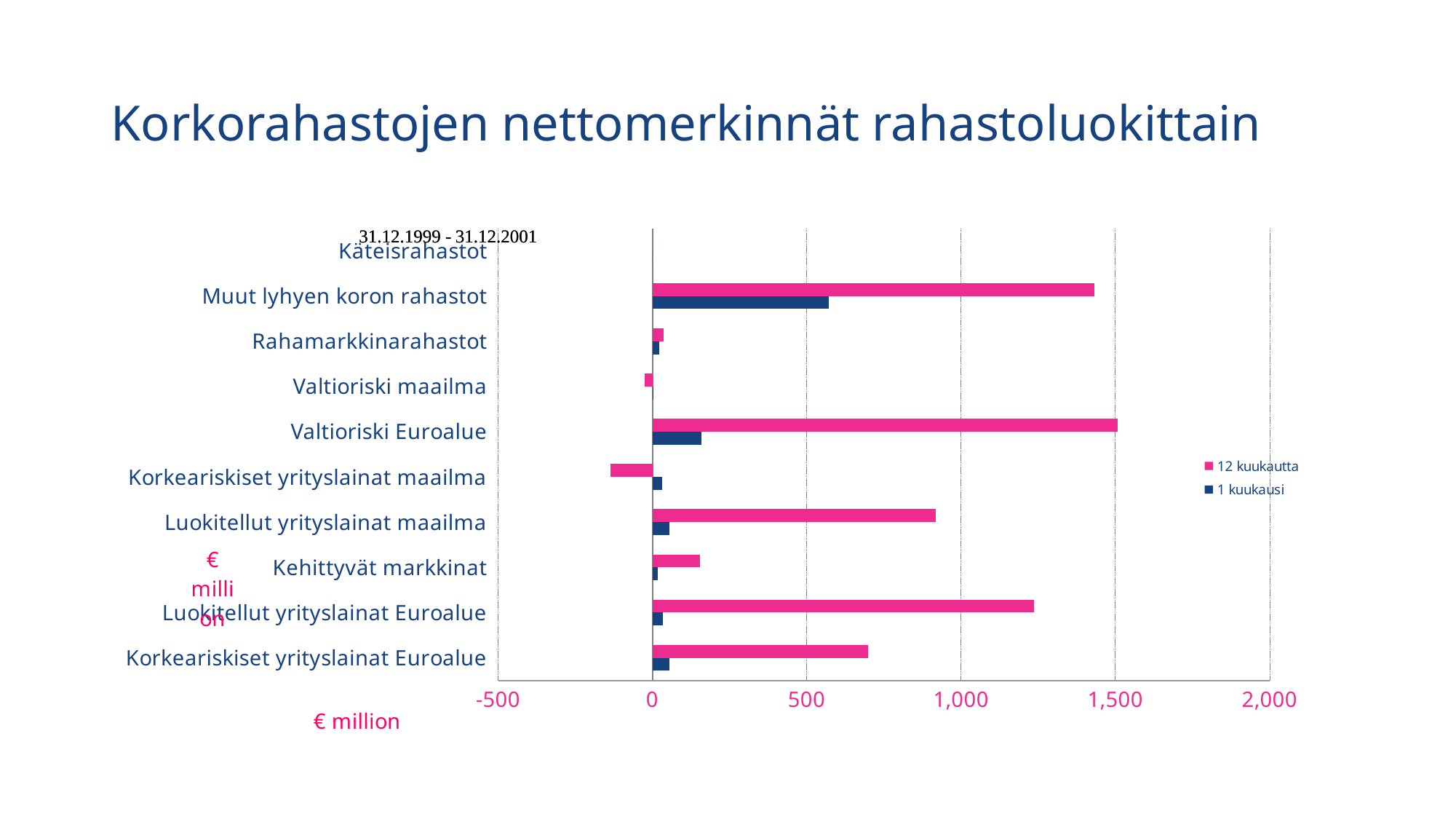
For the 12 kuukautta series, which is larger: Luokitellut yrityslainat Euroalue or Luokitellut yrityslainat maailma? Luokitellut yrityslainat Euroalue What kind of chart is shown on the slide? bar chart How many fund categories are listed on the vertical axis? 10 How many series does the legend list? 2 What unit is shown on the horizontal axis label? € million Which category has the highest value for the 1 kuukausi series? Muut lyhyen koron rahastot Which category has the lowest value for the 12 kuukautta series? Korkeariskiset yrityslainat maailma Is the 12 kuukautta value for Muut lyhyen koron rahastot greater or less than 1,000? greater Is the 12 kuukautta value for Korkeariskiset yrityslainat maailma greater or less than 0? less Is the 1 kuukausi value for Muut lyhyen koron rahastot greater or less than 500? greater Which category has the highest value for the 12 kuukautta series? Valtioriski Euroalue